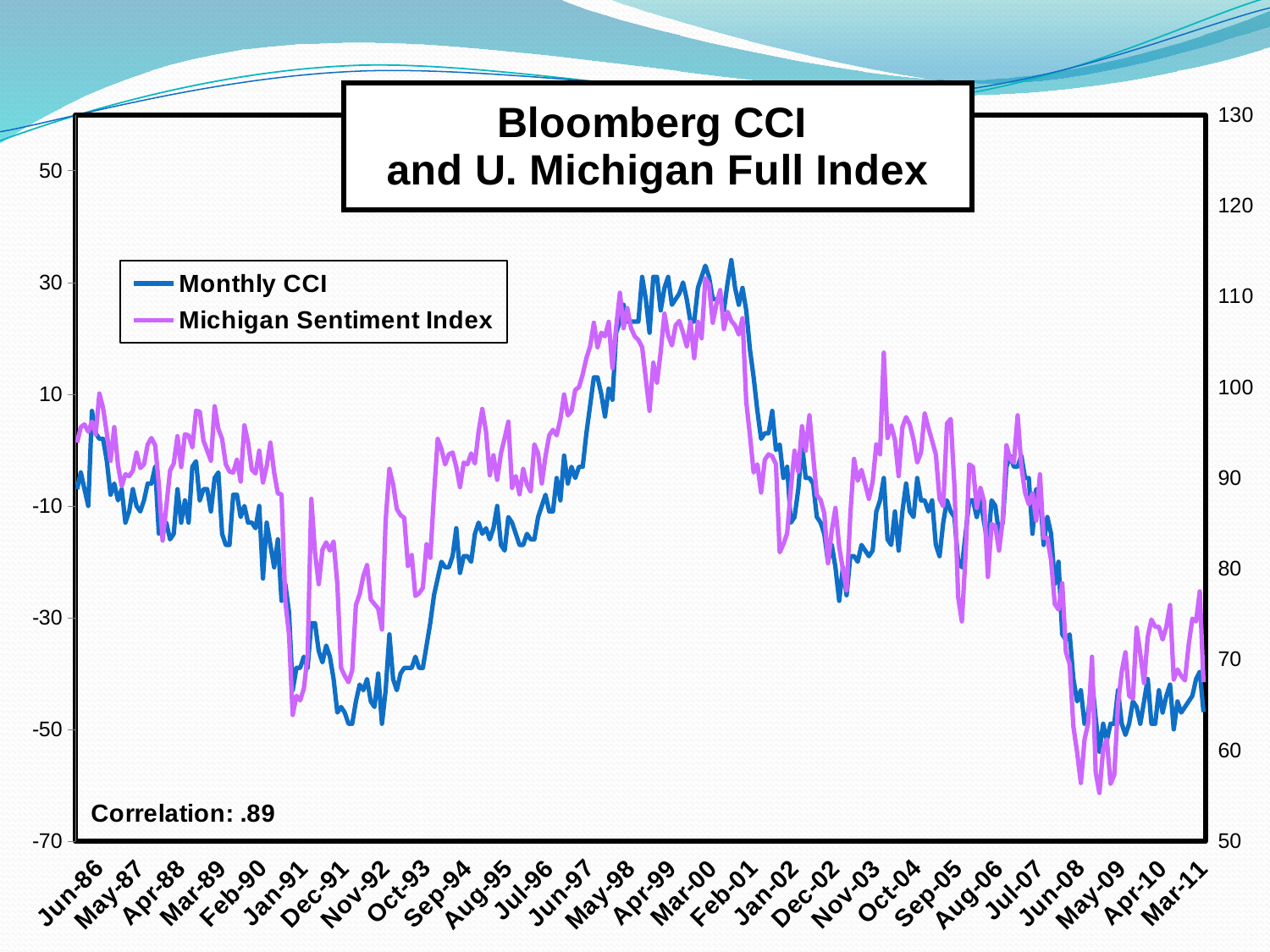
Is the Michigan Sentiment Index value around Mar-00 greater or less than 100? greater Which series is higher on its own axis around Jun-08: Monthly CCI (left axis) or Michigan Sentiment Index (right axis) relative to their axis midpoints? Answer which series is drawn in blue. Monthly CCI What is the title of the chart? Bloomberg CCI and U. Michigan Full Index What kind of chart is shown on the slide? line chart Is the Monthly CCI value around Mar-00 greater or less than 10? greater Does the Monthly CCI series generally rise or fall between Jan-91 and Mar-00? rise Does the Monthly CCI series generally rise or fall between Feb-01 and Jun-08? fall How many series does the legend list? 2 What correlation value is printed on the chart? .89 Is the Monthly CCI value around Jan-91 greater or less than -30? less